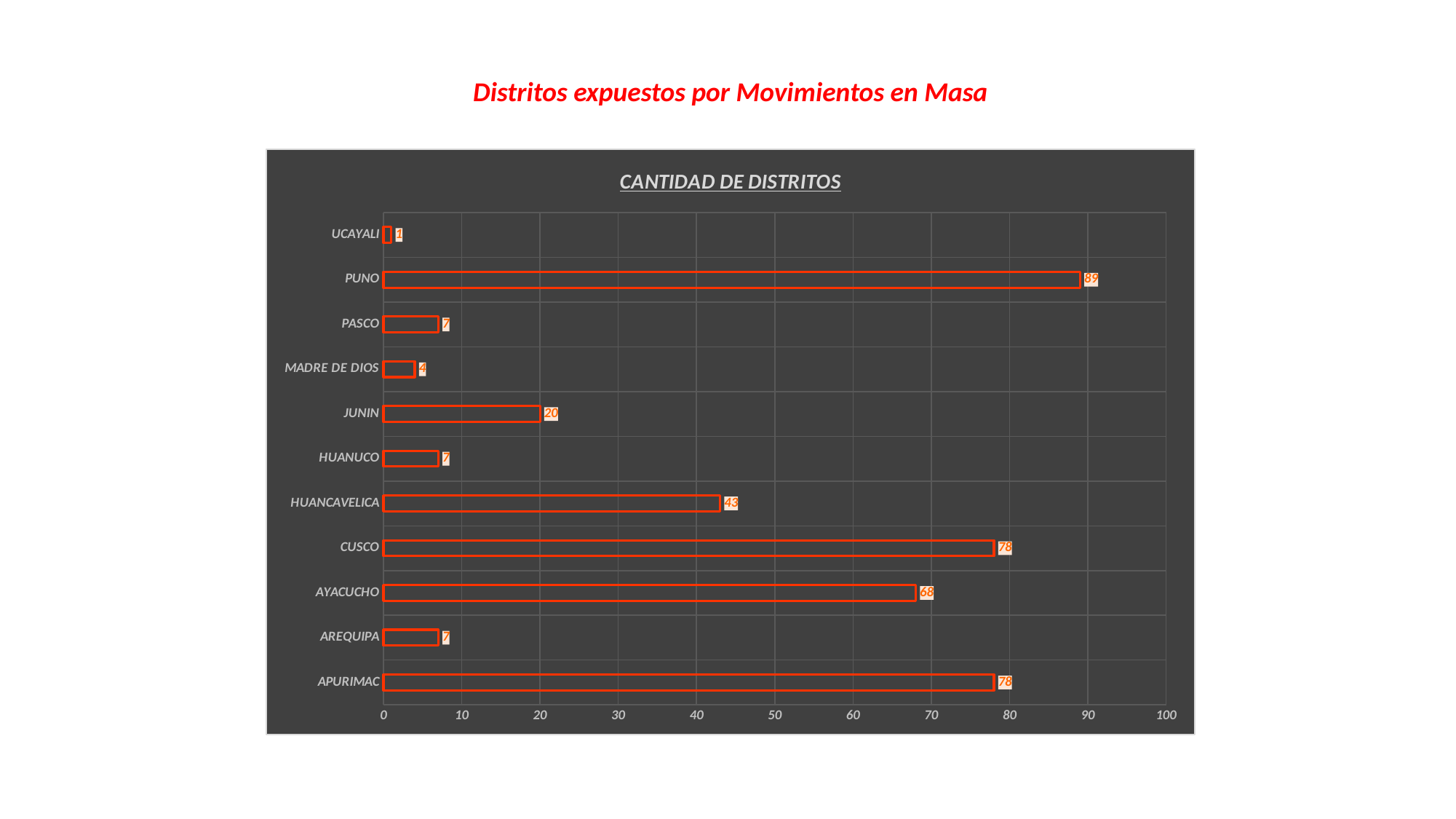
What is the value for JUNIN? 20 Which category has the lowest value? UCAYALI Is the value for HUANCAVELICA greater or less than 50? less What is the difference between the values for PUNO and AYACUCHO? 21 What kind of chart is shown on the slide? bar chart What is the value for PUNO? 89 What is the value for MADRE DE DIOS? 4 Which category has the highest value? PUNO Which is larger, the value for CUSCO or the value for AYACUCHO? CUSCO What is the value for HUANCAVELICA? 43 What is the title of the chart? CANTIDAD DE DISTRITOS How many categories are shown on the chart? 11